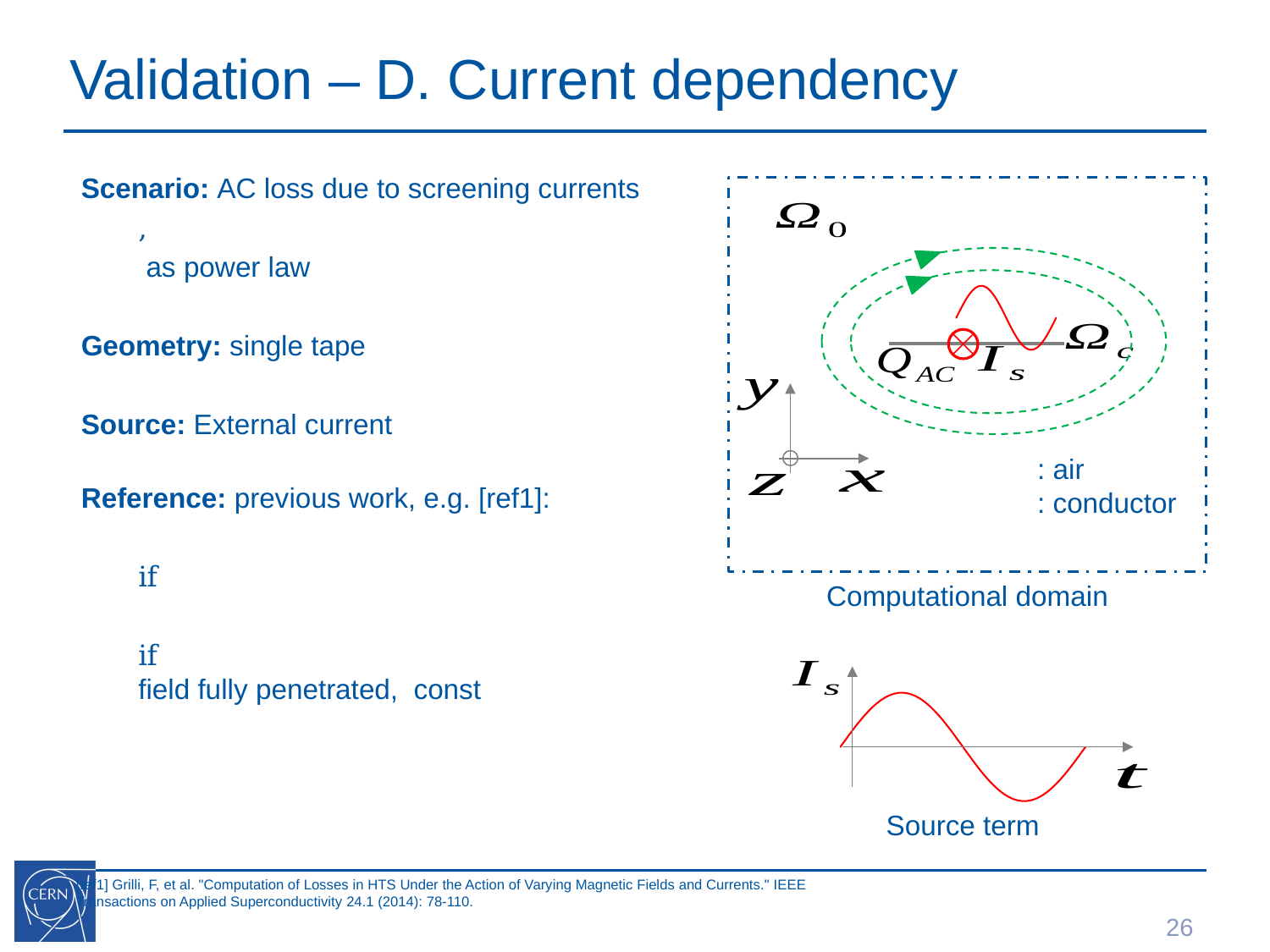
In the Source term plot, what is the label on the horizontal axis? t What is the caption under the plot of I_s versus t? Source term In the Source term plot, does the curve first rise or first fall from the origin along the t axis? rise In the Source term plot, what is the label on the vertical axis? I_s